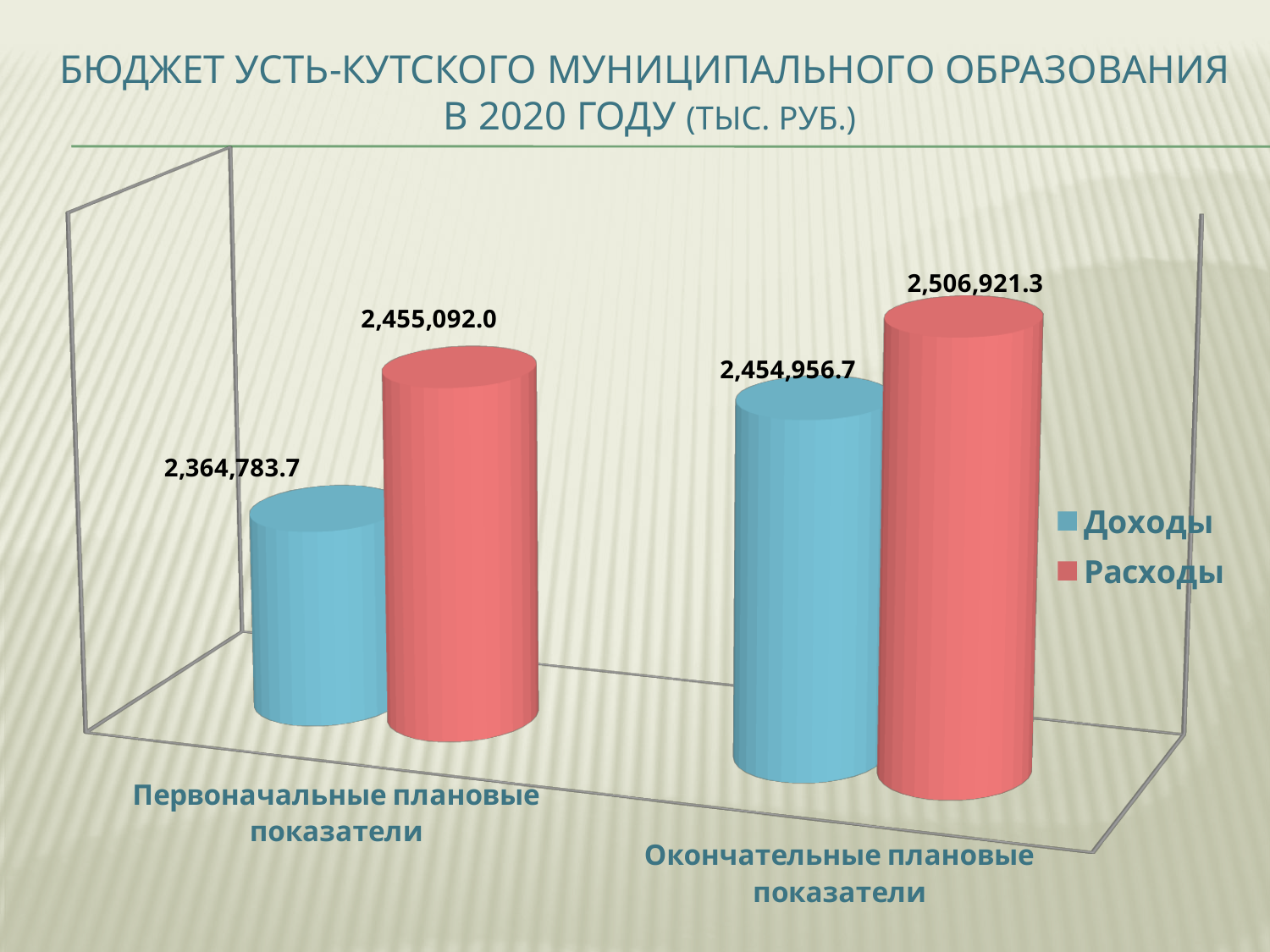
How many series does the legend list? 2 By how much did Расходы increase from Первоначальные to Окончательные плановые показатели? 51,829.3 What is the value of Доходы for Окончательные плановые показатели? 2,454,956.7 Which bar has the highest value on the chart? Расходы, Окончательные плановые показатели (2,506,921.3) What is the value of Расходы for Первоначальные плановые показатели? 2,455,092.0 What is the value of Расходы for Окончательные плановые показатели? 2,506,921.3 What is the difference between Расходы and Доходы for Окончательные плановые показатели? 51,964.6 What is the difference between Расходы and Доходы for Первоначальные плановые показатели? 90,308.3 What kind of chart is shown on the slide? Bar chart What is the value of Доходы for Первоначальные плановые показатели? 2,364,783.7 Which is larger for Первоначальные плановые показатели: Доходы or Расходы? Расходы Which bar has the lowest value on the chart? Доходы, Первоначальные плановые показатели (2,364,783.7)